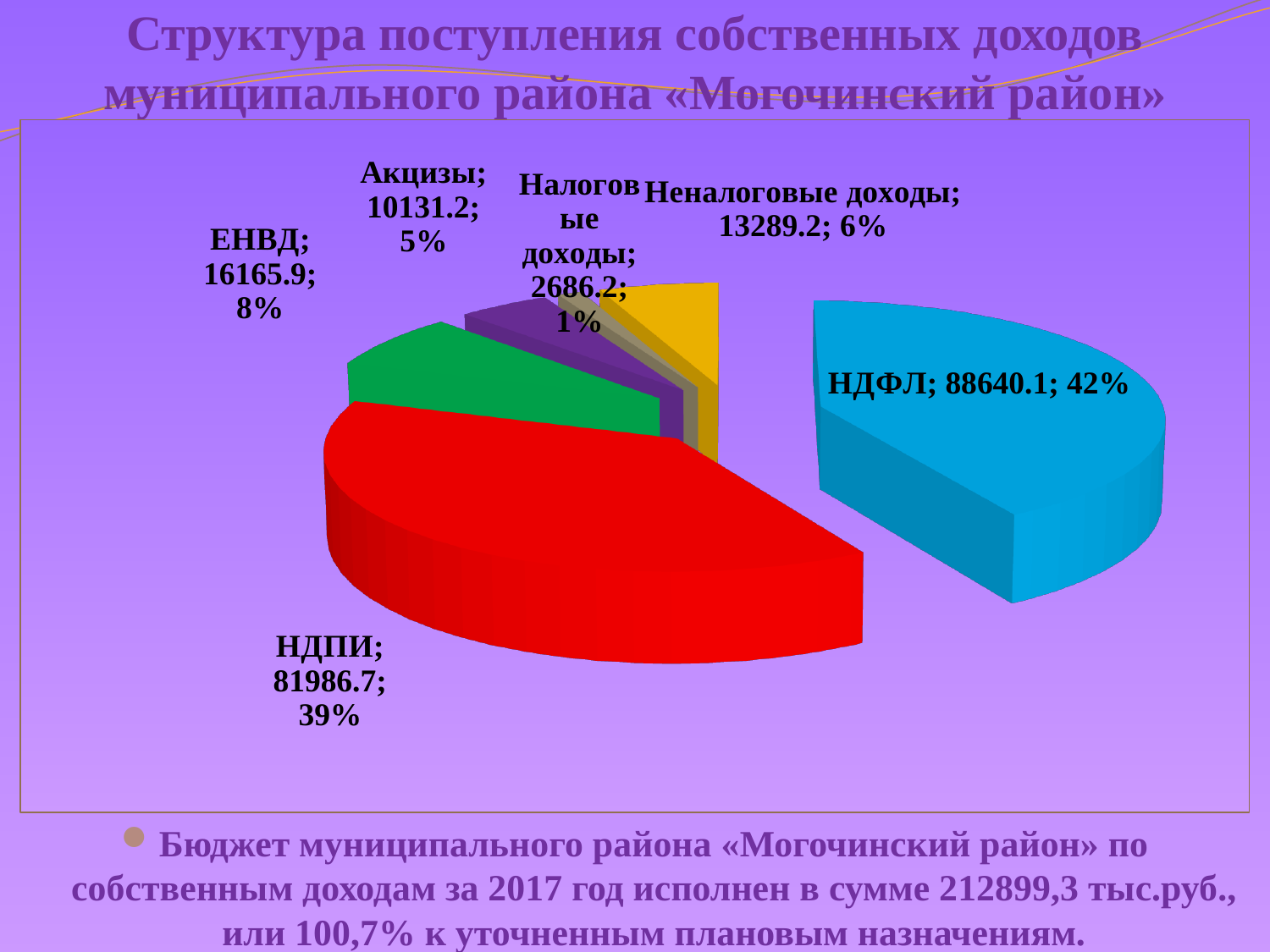
What share of the pie does Акцизы represent? 5% What is the value shown for ЕНВД? 16165.9 What colour is the НДПИ slice? Red What is the difference between the values for НДФЛ and НДПИ? 6653.4 What is the value shown for НДФЛ? 88640.1 Which category has the largest slice of the pie? НДФЛ What share of the pie does Неналоговые доходы represent? 6% What type of chart is shown on the slide? Pie chart Which category has the smallest slice of the pie? Налоговые доходы What share of the pie does НДПИ represent? 39% Which is larger, the value for Акцизы or the value for Неналоговые доходы? Неналоговые доходы How many slices does the pie chart have? 6